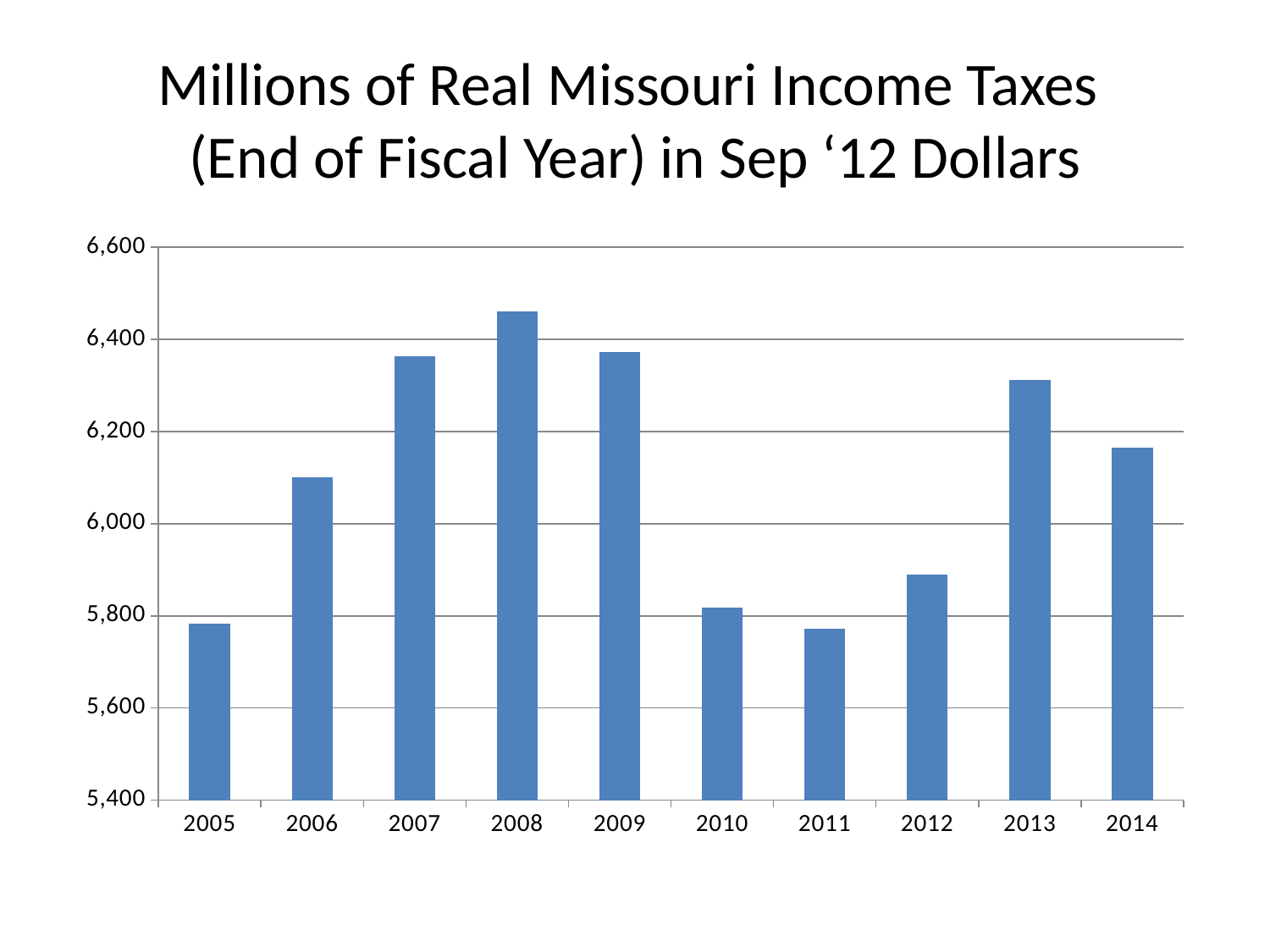
Is the value for 2008 greater or less than 6,400? greater Is the value for 2013 greater or less than 6,200? greater Which year has the highest value on the chart? 2008 What is the title of the chart? Millions of Real Missouri Income Taxes (End of Fiscal Year) in Sep '12 Dollars Which is larger, the value for 2006 or the value for 2012? 2006 How many years are plotted on the chart? 10 Is the value for 2014 greater or less than 6,200? less What kind of chart is shown on the slide? bar chart Which is larger, the value for 2013 or the value for 2014? 2013 Do the values rise or fall from 2008 to 2011? fall